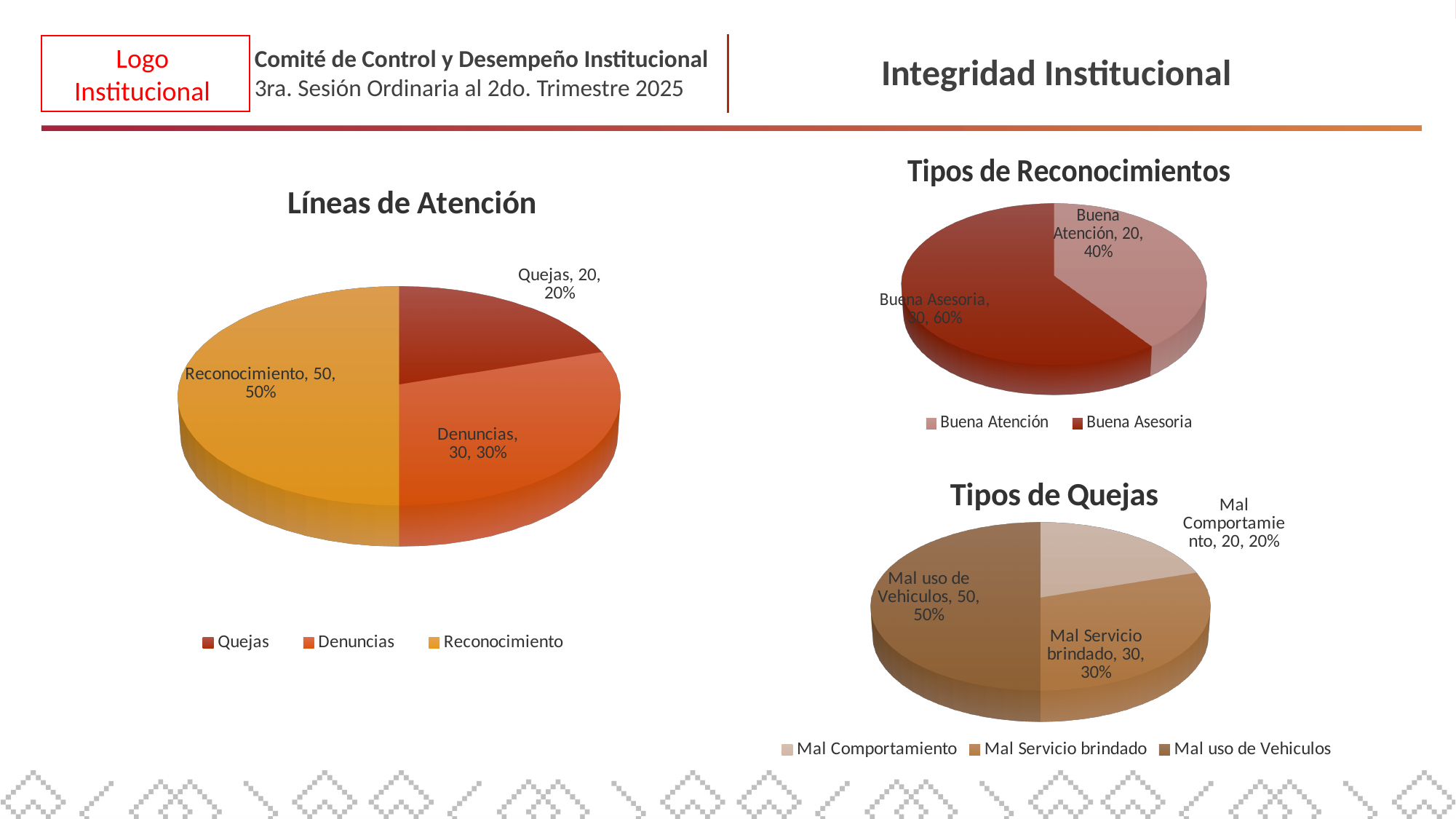
In the 'Tipos de Quejas' chart, what is the value for Mal Servicio brindado? 30 In the 'Tipos de Reconocimientos' chart, what percentage share does Buena Atención have? 40% In the 'Líneas de Atención' chart, which category has the largest slice? Reconocimiento In the 'Tipos de Quejas' chart, which category has the largest slice? Mal uso de Vehiculos In the 'Tipos de Reconocimientos' chart, what is the value for Buena Asesoria? 30 In the 'Líneas de Atención' chart, what share of the pie does Reconocimiento represent? 50% In the 'Tipos de Reconocimientos' chart, which is larger: Buena Atención or Buena Asesoria? Buena Asesoria How many categories does the 'Líneas de Atención' chart show? 3 In the 'Líneas de Atención' chart, what is the value for Denuncias? 30 What type of chart is 'Tipos de Quejas'? Pie chart In the 'Líneas de Atención' chart, which category has the smallest slice? Quejas In the 'Líneas de Atención' chart, what is the difference between the values for Reconocimiento and Quejas? 30